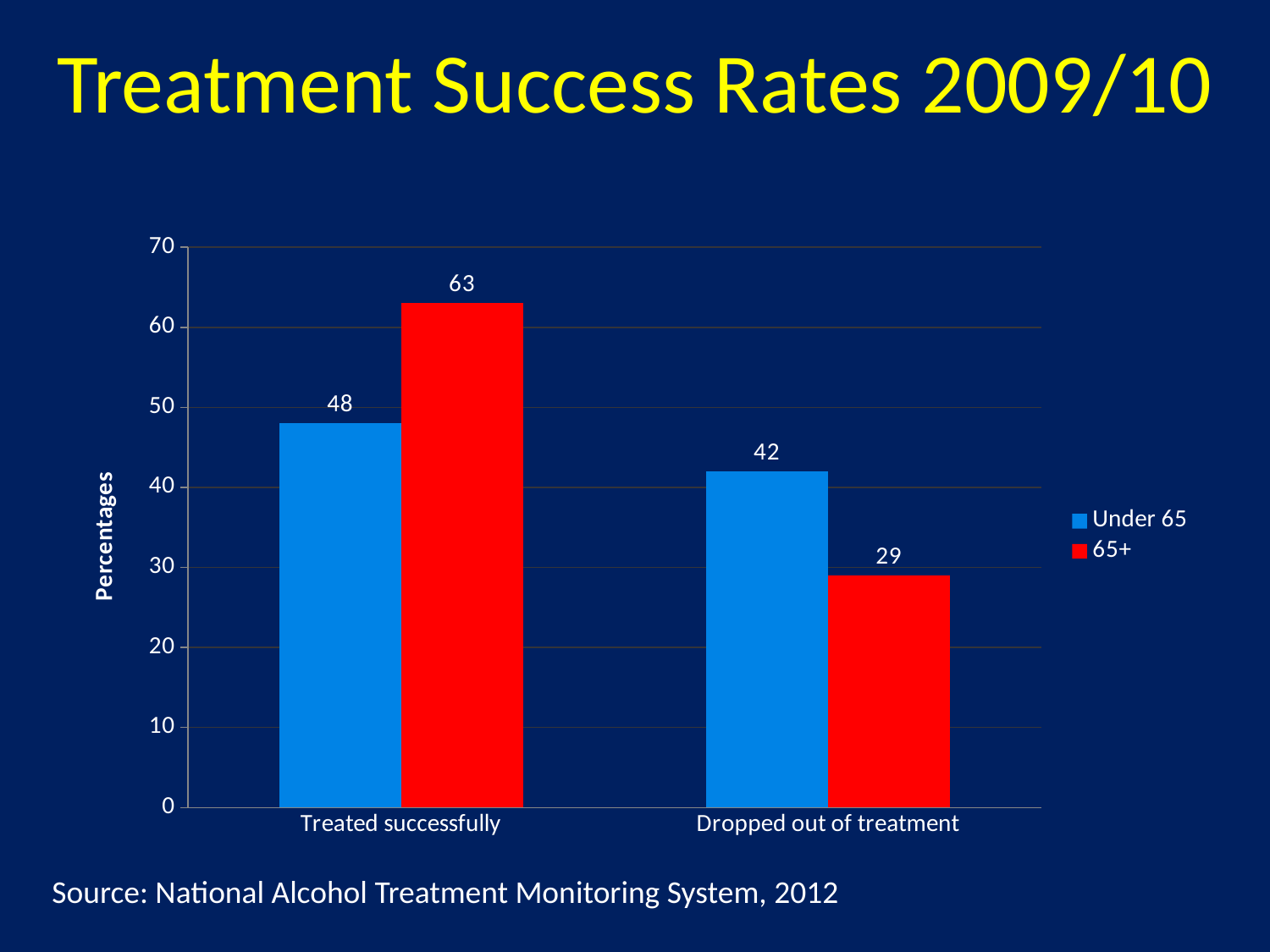
What is the value for Under 65 in the Treated successfully category? 48 Which bar has the lowest value on the chart? 65+, Dropped out of treatment What is the value for 65+ in the Treated successfully category? 63 What is the difference between the Under 65 and 65+ values for Dropped out of treatment? 13 Which is larger for Dropped out of treatment: Under 65 or 65+? Under 65 What is the value for Under 65 in the Dropped out of treatment category? 42 How many series does the legend list? 2 What kind of chart is shown on the slide? Bar chart Which bar has the highest value on the chart? 65+, Treated successfully What is the difference between the 65+ and Under 65 values for Treated successfully? 15 How many categories are shown on the x axis? 2 What is the value for 65+ in the Dropped out of treatment category? 29